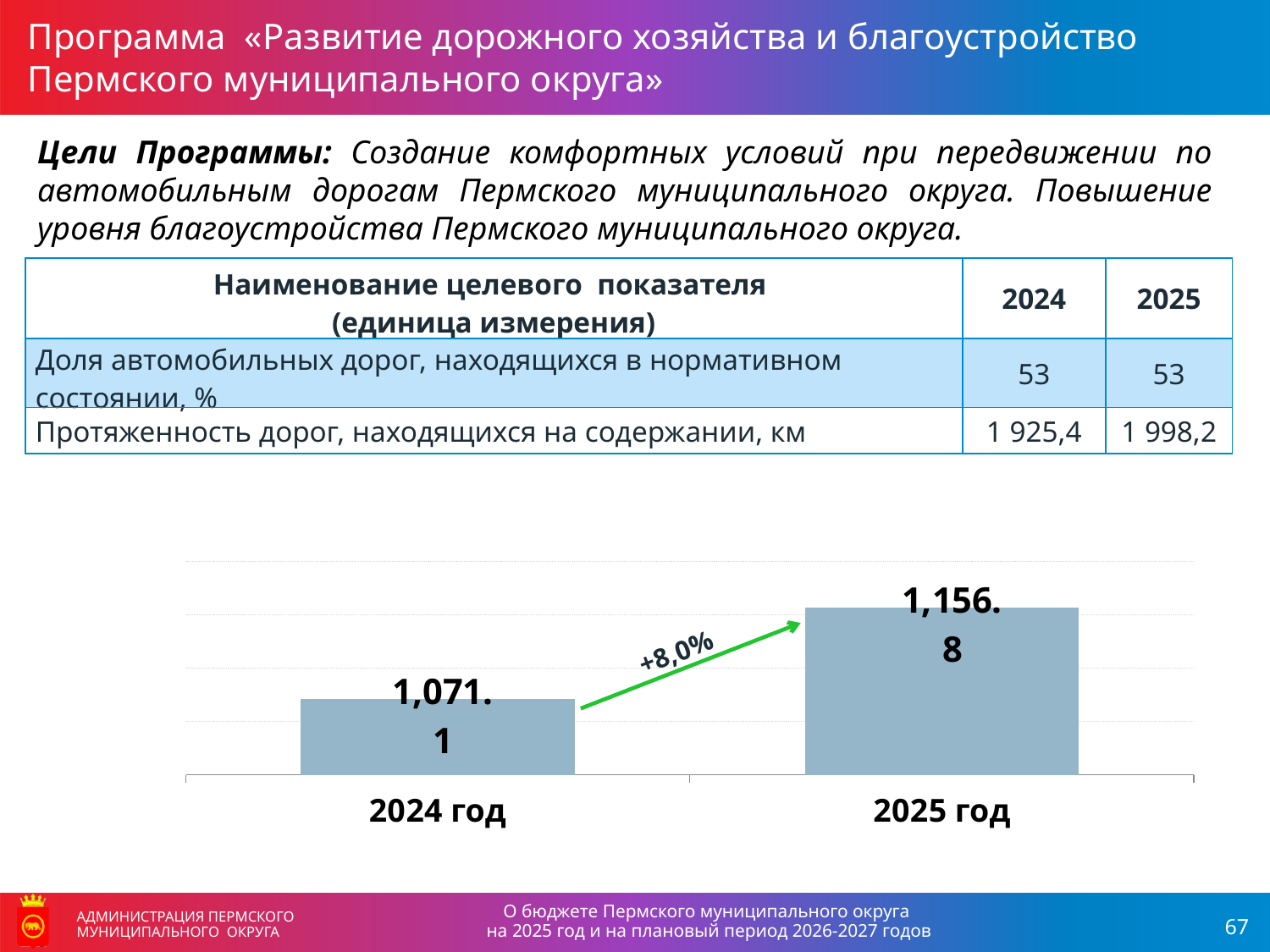
What kind of chart is shown on the slide? bar chart Which year has the lower bar in the chart? 2024 год Do the values rise or fall from 2024 год to 2025 год? rise What is the value of the bar for 2024 год? 1,071.1 By how much does the value for 2025 год exceed the value for 2024 год? 85.7 Is the value for 2025 год larger or smaller than the value for 2024 год? larger What is the value of the bar for 2025 год? 1,156.8 What percentage change is written next to the arrow between the two bars? +8,0% Which year has the higher bar in the chart? 2025 год What are the two category labels on the x axis of the chart? 2024 год and 2025 год How many bars are plotted in the chart? 2